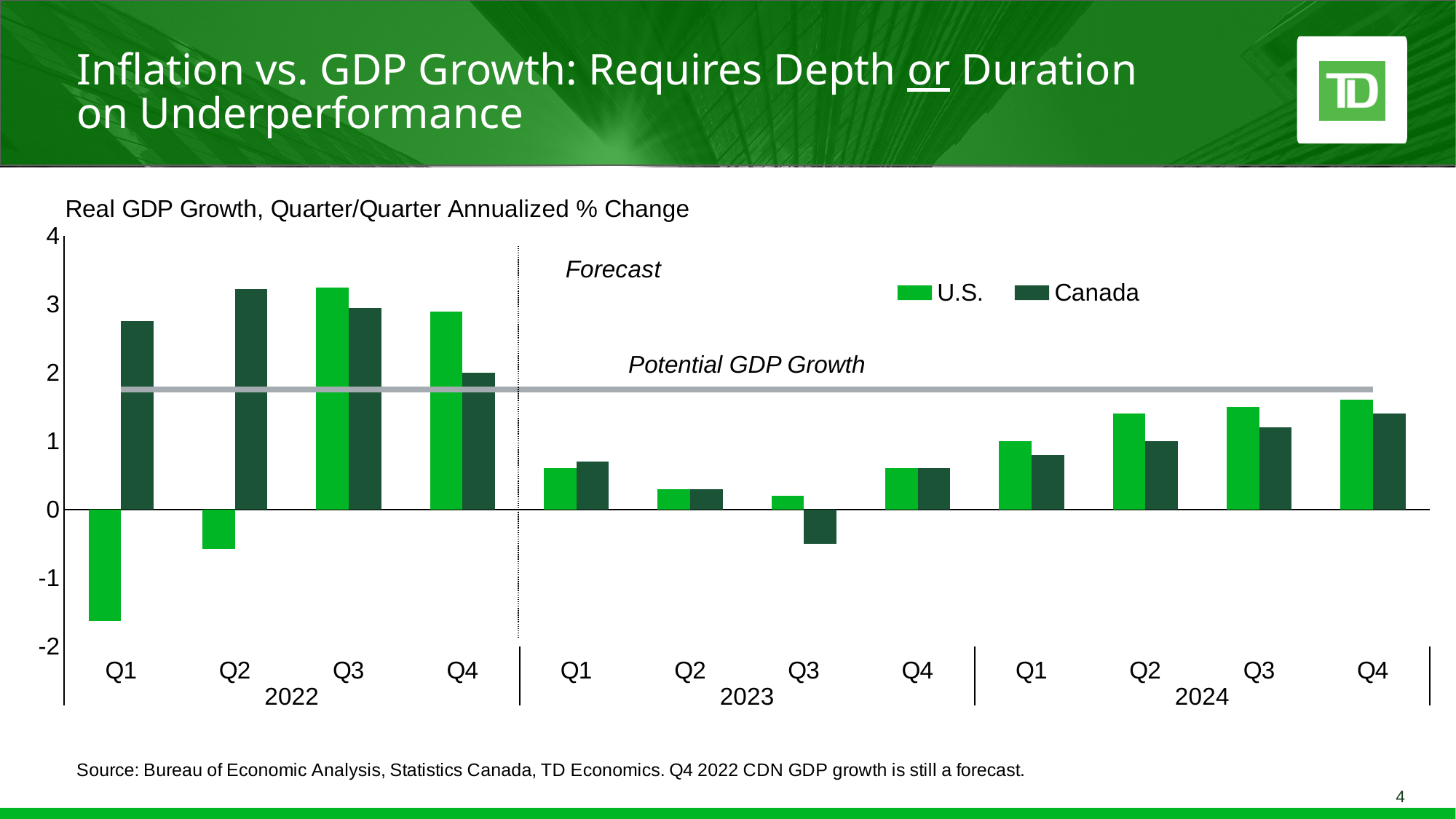
Is the U.S. value for Q1 2022 greater or less than -1? less In Q4 2022, which is larger, the U.S. value or the Canada value? U.S. In which quarter is the U.S. value lowest? Q1 2022 What type of chart is shown on the slide? Bar chart In which quarter is the Canada value highest? Q2 2022 In which quarter is the Canada value lowest? Q3 2023 Is the U.S. value for Q4 2022 greater or less than 2? greater Is the Canada value for Q2 2022 greater or less than 3? greater Do the U.S. values rise or fall across the four quarters of 2024? Rise How many series does the legend list? 2 What does the horizontal grey line on the chart represent? Potential GDP Growth How many quarters are shown along the x axis? 12